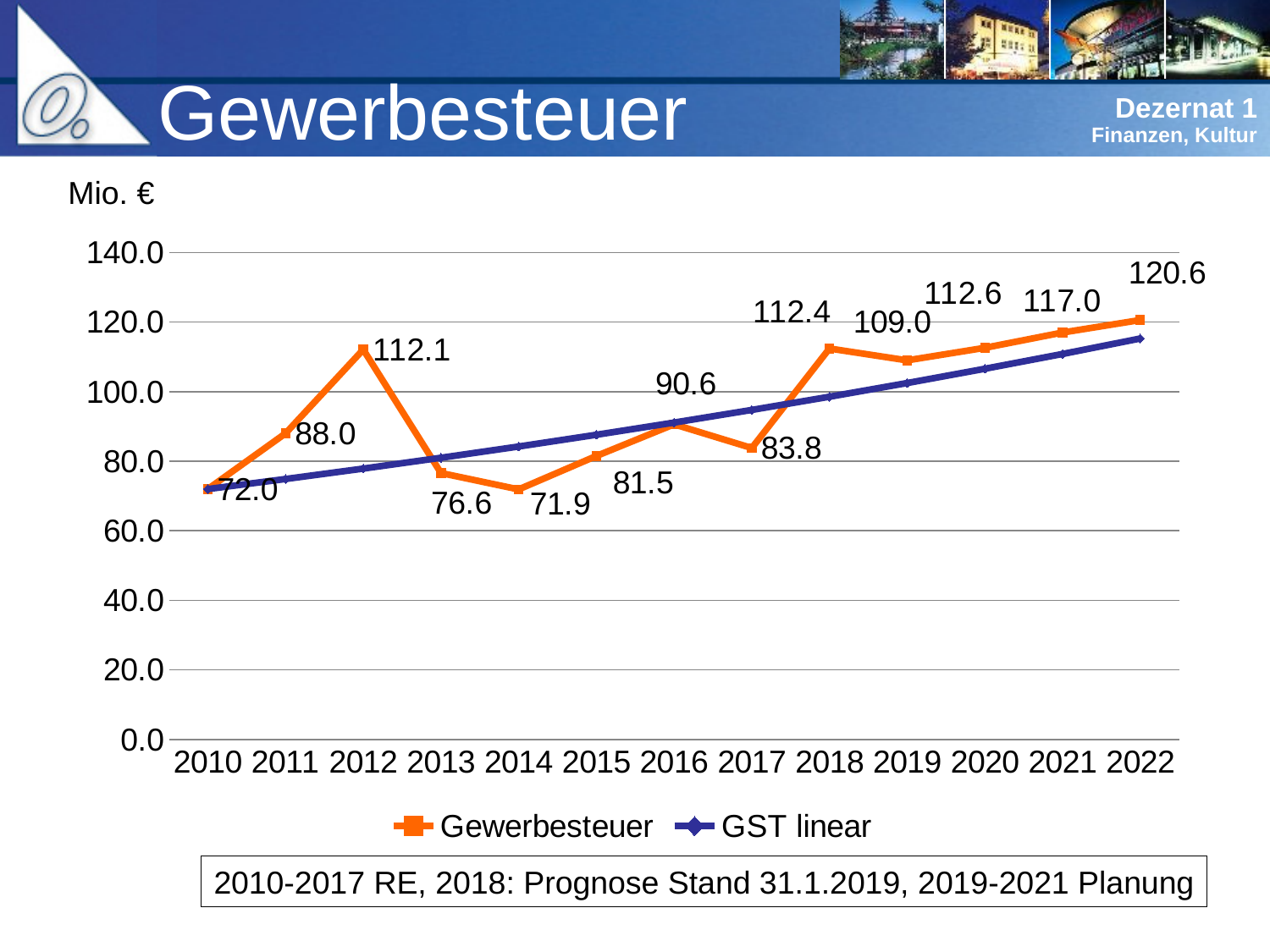
What is the Gewerbesteuer value for 2012? 112.1 What is the Gewerbesteuer value for 2018? 112.4 Which year has the lowest Gewerbesteuer value? 2014 How many series does the legend list? 2 How many years are shown on the x axis? 13 What kind of chart is shown on the slide? line chart Is the GST linear value for 2022 greater or less than 100.0? greater Does the GST linear series rise or fall from 2010 to 2022? rise Which is larger, the Gewerbesteuer value for 2011 or for 2017? 2011 Which year has the highest Gewerbesteuer value? 2022 What is the difference between the Gewerbesteuer values for 2021 and 2020? 4.4 What is the Gewerbesteuer value for 2022? 120.6